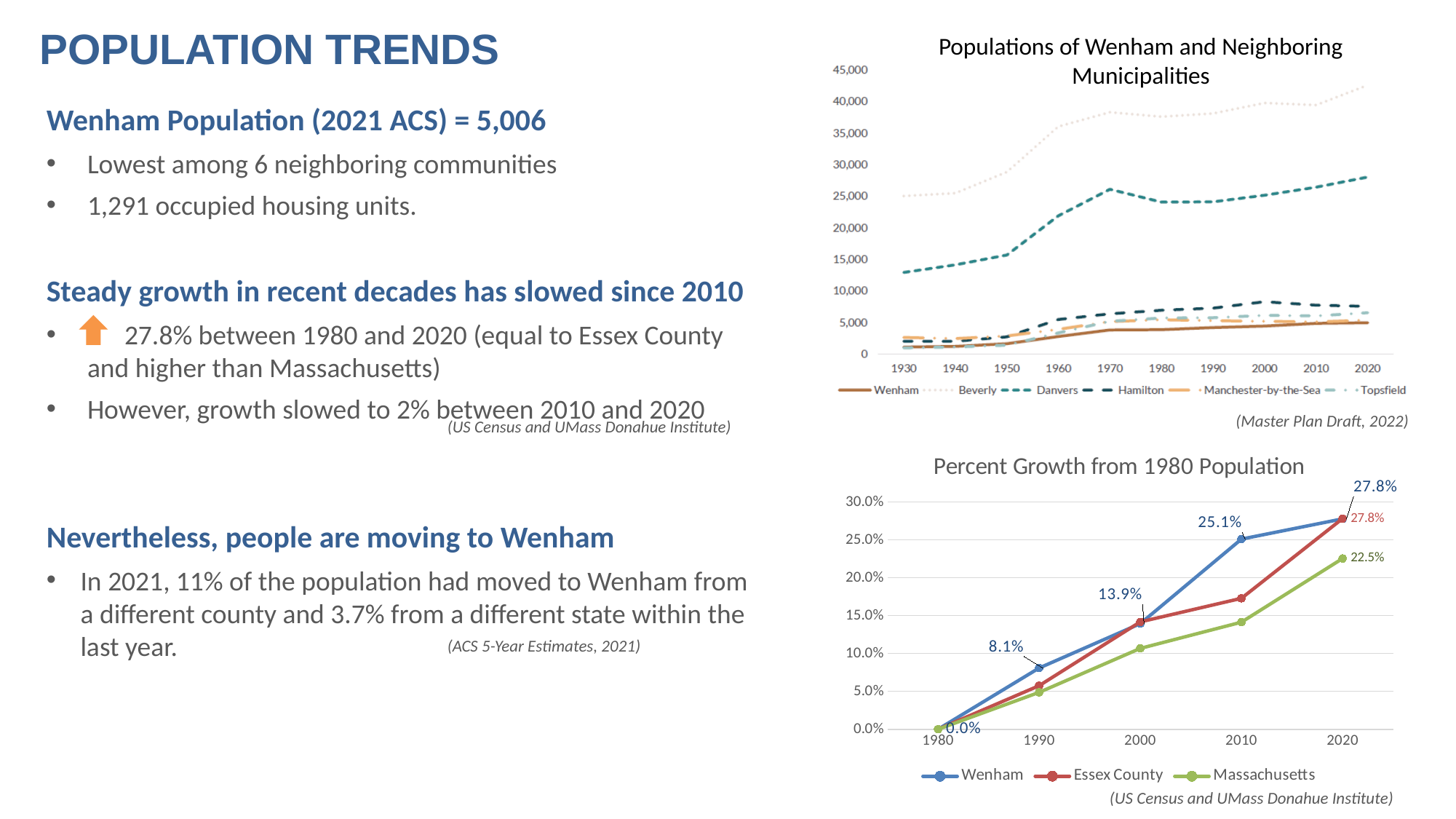
In the 'Populations of Wenham and Neighboring Municipalities' chart, how many series does the legend list? 6 In the 'Percent Growth from 1980 Population' chart, how many series does the legend list? 3 In the 'Percent Growth from 1980 Population' chart, what is the value for Massachusetts in 2020? 22.5% In the 'Percent Growth from 1980 Population' chart, what is the value for Wenham in 1990? 8.1% In the 'Percent Growth from 1980 Population' chart, what is the value for Wenham in 2000? 13.9% In the 'Percent Growth from 1980 Population' chart, what is the difference between Wenham's 2020 value and Massachusetts' 2020 value? 5.3% In the 'Percent Growth from 1980 Population' chart, what is the value for Wenham in 2010? 25.1% In the 'Percent Growth from 1980 Population' chart, does the Wenham line rise or fall from 1980 to 2020? rise What kind of chart is 'Populations of Wenham and Neighboring Municipalities'? line chart In the 'Percent Growth from 1980 Population' chart, is the value for Massachusetts in 2010 greater or less than 15.0%? less In the 'Percent Growth from 1980 Population' chart, which series has the lowest value in 2020? Massachusetts In the 'Populations of Wenham and Neighboring Municipalities' chart, which municipality has the highest population in 2020? Beverly